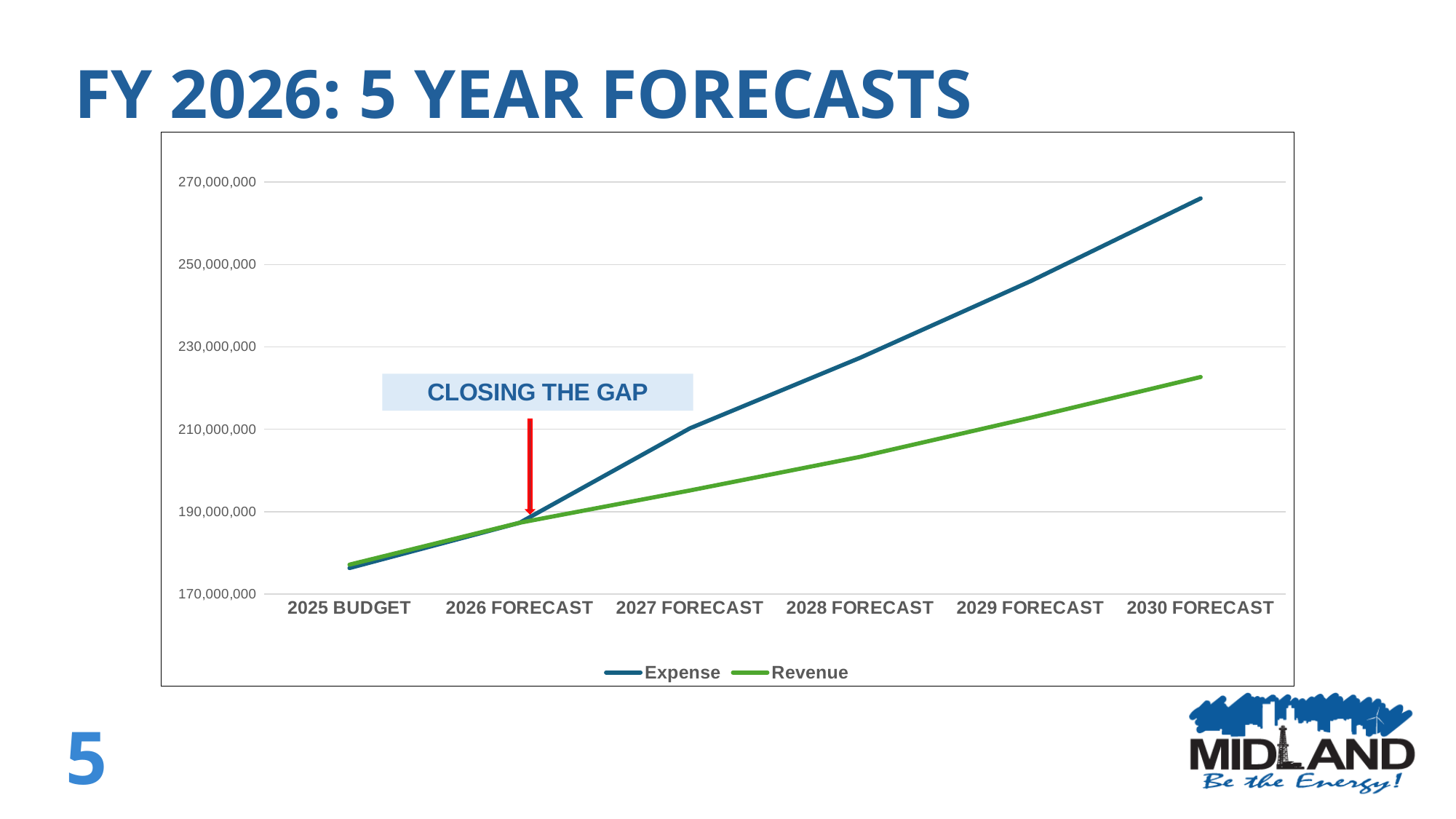
At 2030 FORECAST, which is larger, Expense or Revenue? Expense Is the Revenue value for 2030 FORECAST greater or less than 230,000,000? less Do the Expense values rise or fall from 2025 BUDGET to 2030 FORECAST? rise How many categories are shown along the x axis? 6 What text appears in the annotation box above the 2026 FORECAST point? CLOSING THE GAP Is the Revenue value for 2028 FORECAST greater or less than 210,000,000? less Which series are listed in the legend? Expense and Revenue What kind of chart is shown on the slide? line chart Is the Expense value for 2025 BUDGET greater or less than 190,000,000? less At which category does the Expense series reach its highest value? 2030 FORECAST How many series does the legend list? 2